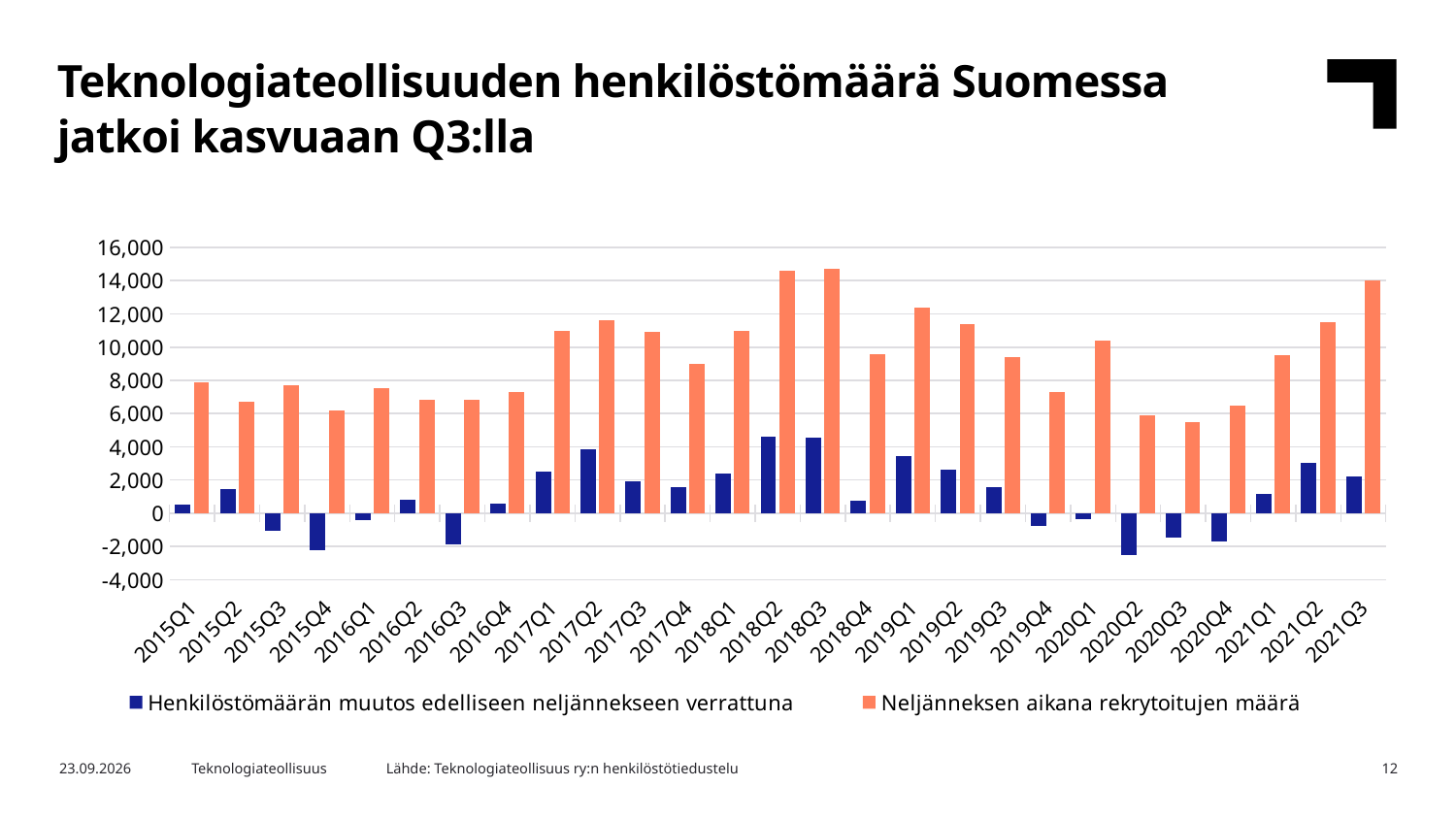
Which is larger for 'Neljänneksen aikana rekrytoitujen määrä': 2018Q2 or 2016Q1? 2018Q2 What kind of chart is shown on the slide? Bar chart Is the value of 'Neljänneksen aikana rekrytoitujen määrä' for 2020Q3 greater or less than 6,000? less Is the value of 'Neljänneksen aikana rekrytoitujen määrä' for 2019Q1 greater or less than 10,000? greater Is the value of 'Neljänneksen aikana rekrytoitujen määrä' for 2021Q3 greater or less than 12,000? greater Which series is shown in orange in the legend? Neljänneksen aikana rekrytoitujen määrä How many quarters are shown on the x axis? 27 Which quarter has the lowest value for 'Henkilöstömäärän muutos edelliseen neljännekseen verrattuna'? 2020Q2 Does the value of 'Neljänneksen aikana rekrytoitujen määrä' rise or fall from 2020Q3 to 2021Q3? rise How many series does the legend list? 2